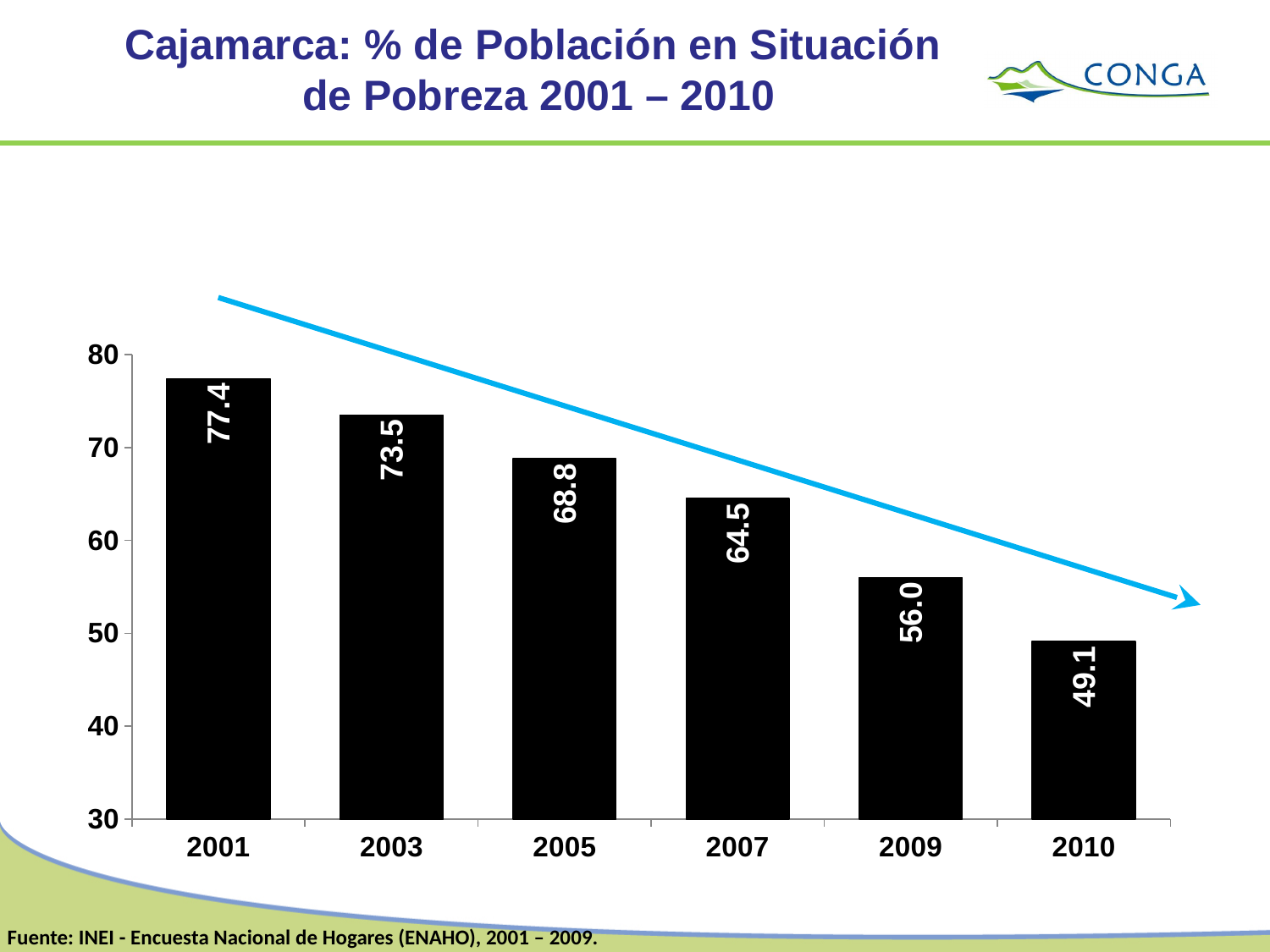
Which year has the lowest value? 2010 Which year has the highest value? 2001 What is the value for 2007? 64.5 What kind of chart is shown? bar chart Which is larger, the value for 2003 or the value for 2009? 2003 How many years are shown on the x axis? 6 What is the difference between the values for 2001 and 2010? 28.3 Do the values rise or fall from 2001 to 2010? fall What is the value for 2010? 49.1 Is the value for 2009 greater or less than 60? less What is the value for 2001? 77.4 What is the difference between the values for 2005 and 2009? 12.8